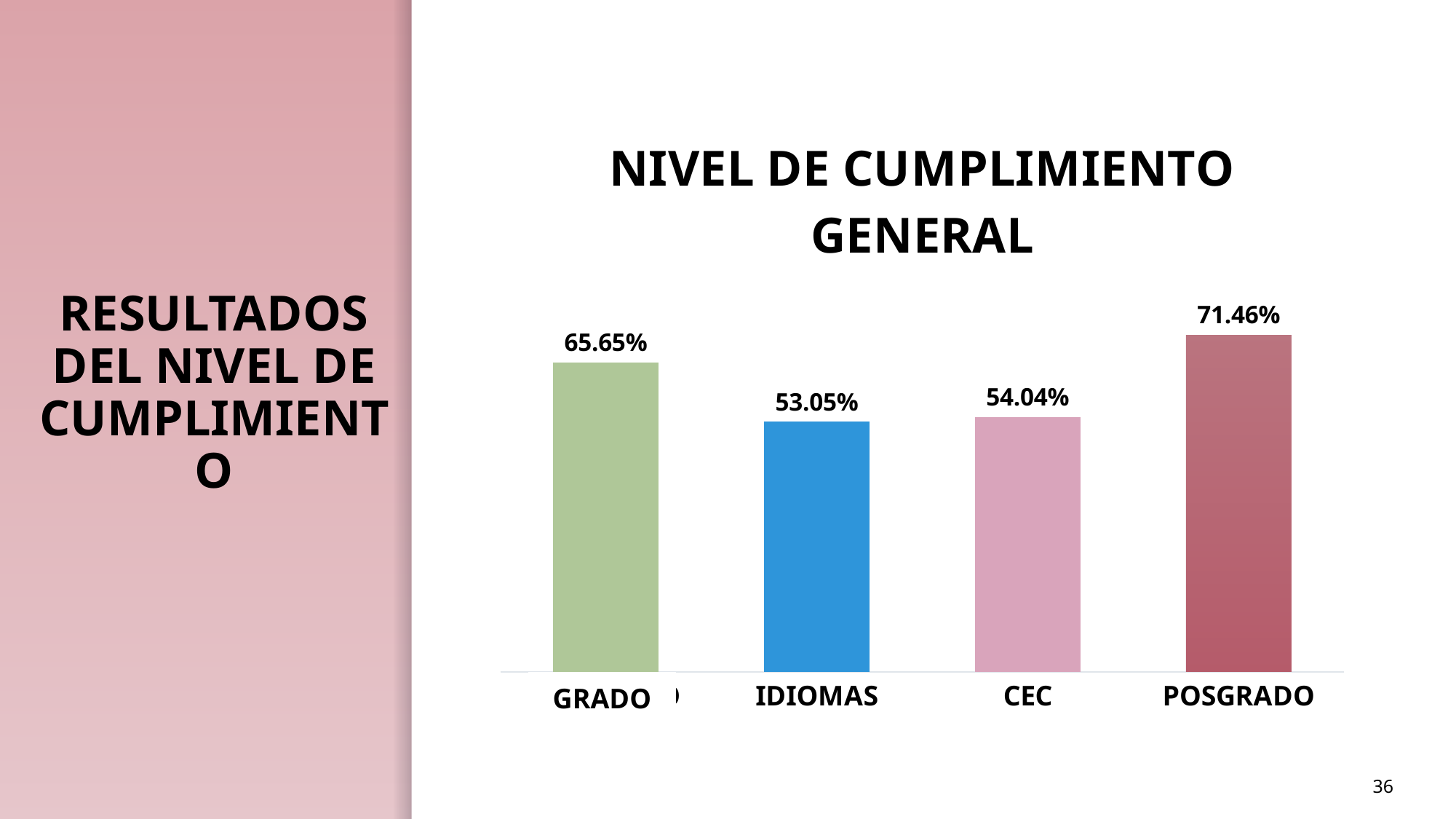
What is the value for IDIOMAS? 53.05% Which is larger, the value for GRADO or the value for CEC? GRADO What is the title of the chart? NIVEL DE CUMPLIMIENTO GENERAL What kind of chart is shown on the slide? Bar chart Which category has the highest value? POSGRADO What is the value for CEC? 54.04% What is the difference between the values for CEC and IDIOMAS? 0.99% What is the difference between the values for POSGRADO and GRADO? 5.81% What is the value for POSGRADO? 71.46% How many categories are shown in the chart? 4 What is the value for GRADO? 65.65% Which category has the lowest value? IDIOMAS